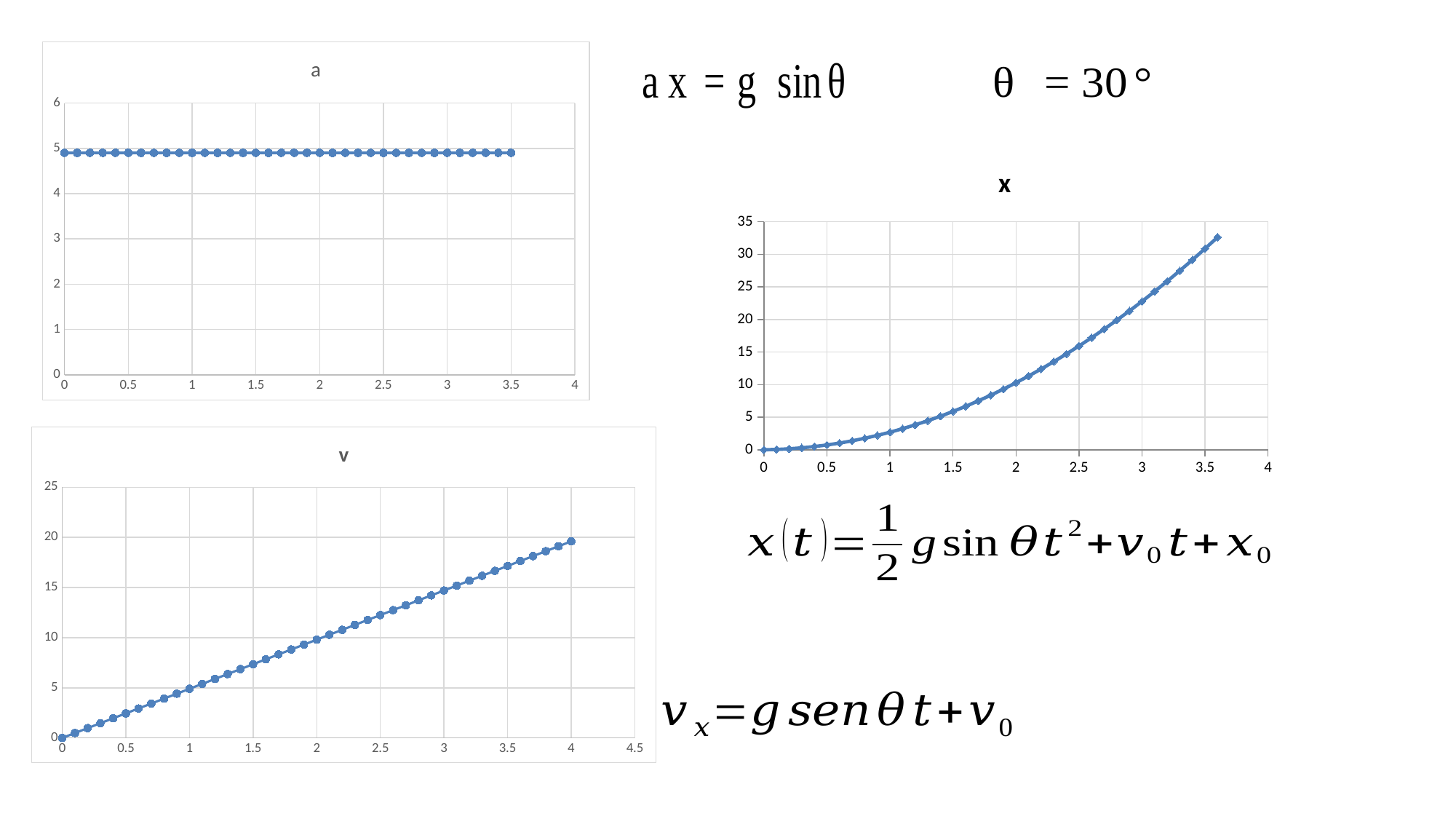
In the chart titled "v", do the values rise or fall along the x axis? rise In the chart titled "x", is the value at x = 1 greater or less than 5? less In the chart titled "x", which is larger: the value at x = 1 or the value at x = 3? the value at x = 3 What kind of chart is the chart titled "a"? line chart In the chart titled "v", is the value at x = 4 greater or less than 15? greater In the chart titled "v", what is the value at x = 0? 0 In the chart titled "v", is the value at x = 2 greater or less than 5? greater In the chart titled "x", do the values rise or fall along the x axis? rise How many charts are shown on the slide? 3 In the chart titled "a", do the values rise, fall or stay constant along the x axis? stay constant